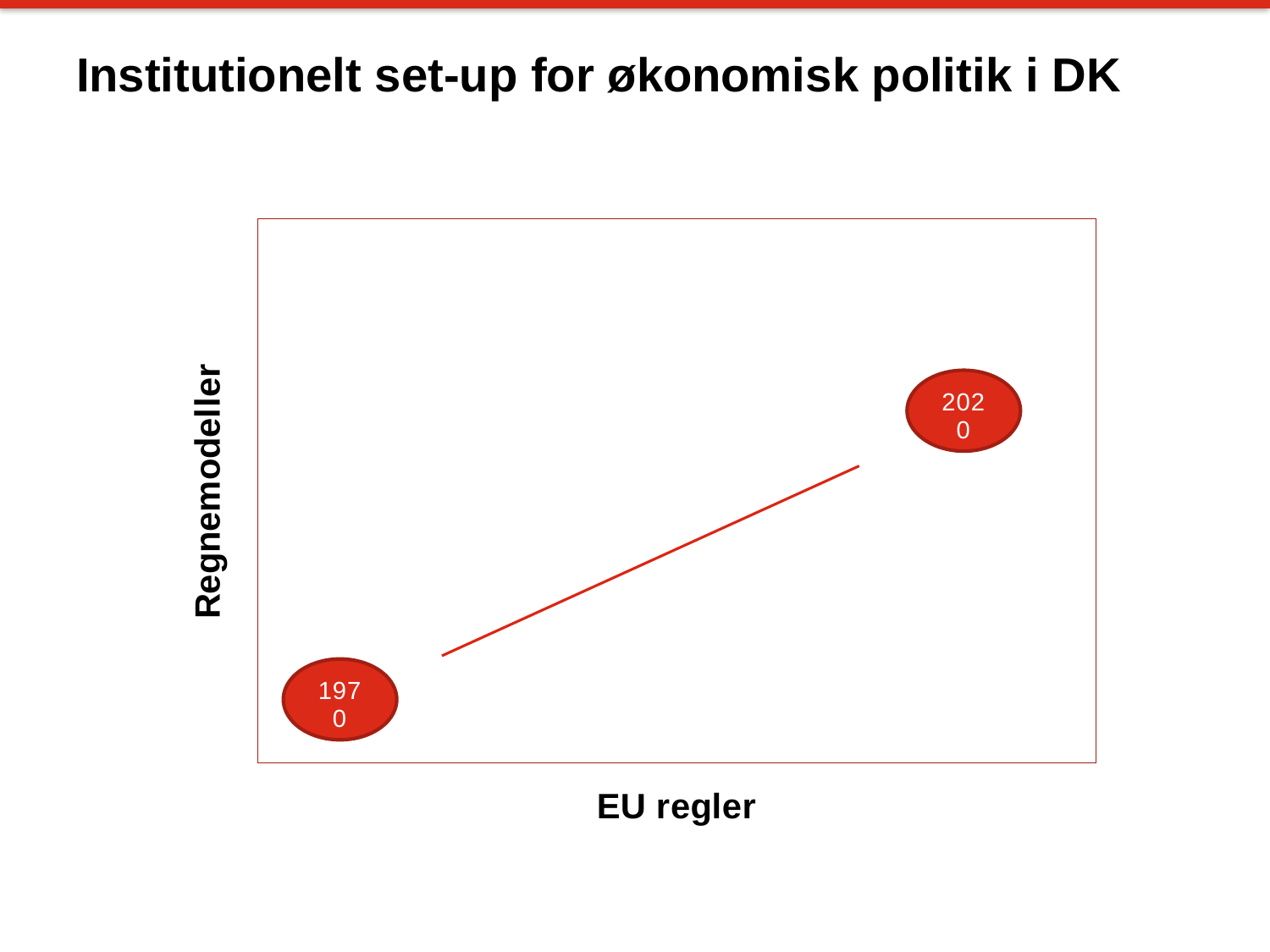
Which point is positioned further to the right on the horizontal axis, 1970 or 2020? 2020 Which point is positioned higher on the vertical axis, 1970 or 2020? 2020 What is the label of the vertical axis of the chart? Regnemodeller Does the line in the chart rise or fall from left to right? rise What is the label of the horizontal axis of the chart? EU regler How many labelled points are shown in the chart? 2